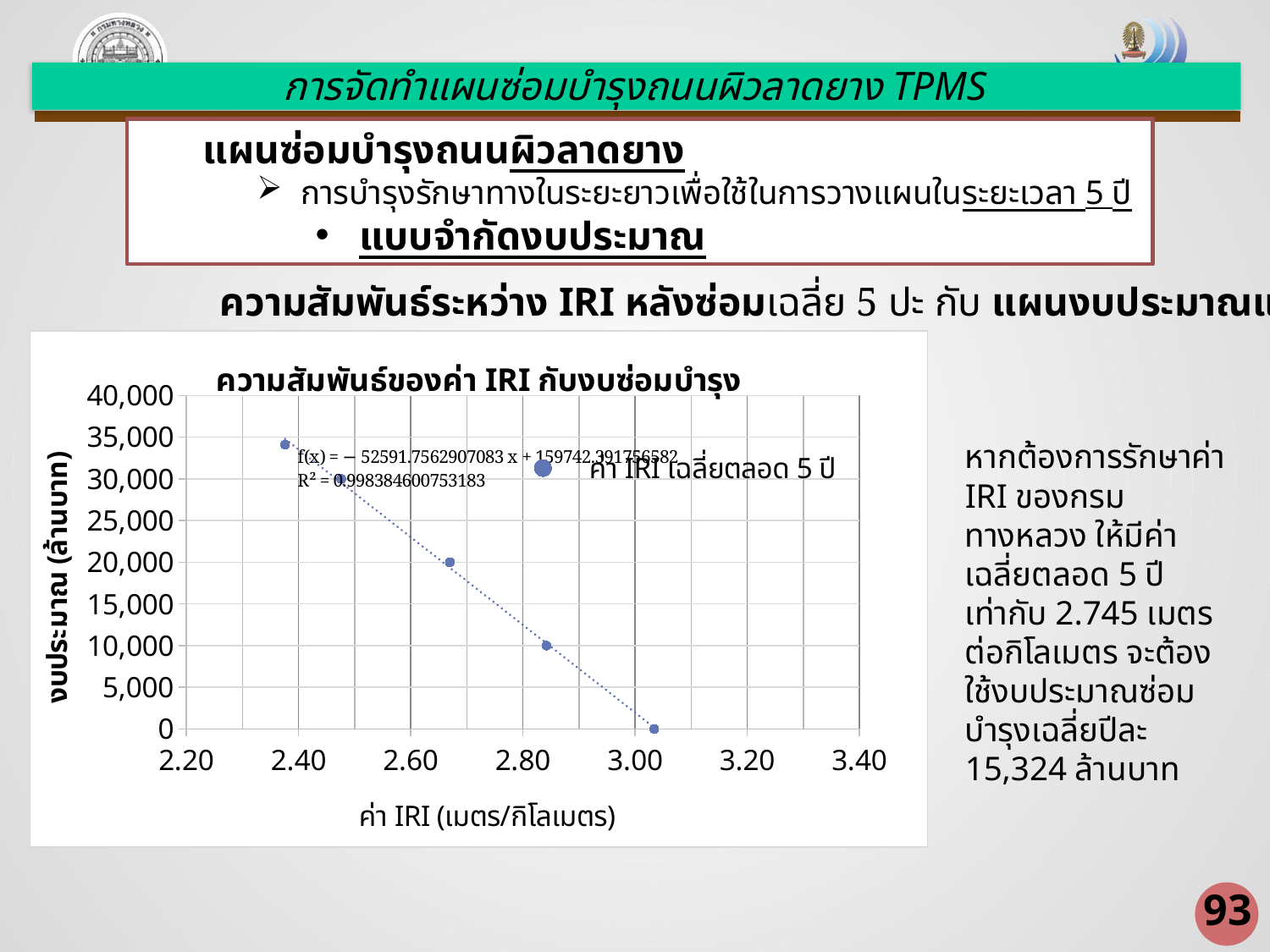
How many series does the chart legend list? 1 What is the title of the chart? ความสัมพันธ์ของค่า IRI กับงบซ่อมบำรุง How many data points are plotted in the chart? 5 What R² value is shown for the trendline on the chart? 0.998384600753183 Is the budget value for the leftmost data point greater or less than 30,000? greater What is the legend entry for the plotted series? ค่า IRI เฉลี่ยตลอด 5 ปี Is the budget value for the rightmost data point greater or less than 5,000? less As the IRI value increases along the x axis, does the budget (งบประมาณ) rise or fall? fall Which data point has the highest budget value, the leftmost or the rightmost? the leftmost Is the budget value for the second data point from the left greater or less than 15,000? greater What kind of chart is shown on the slide? scatter chart